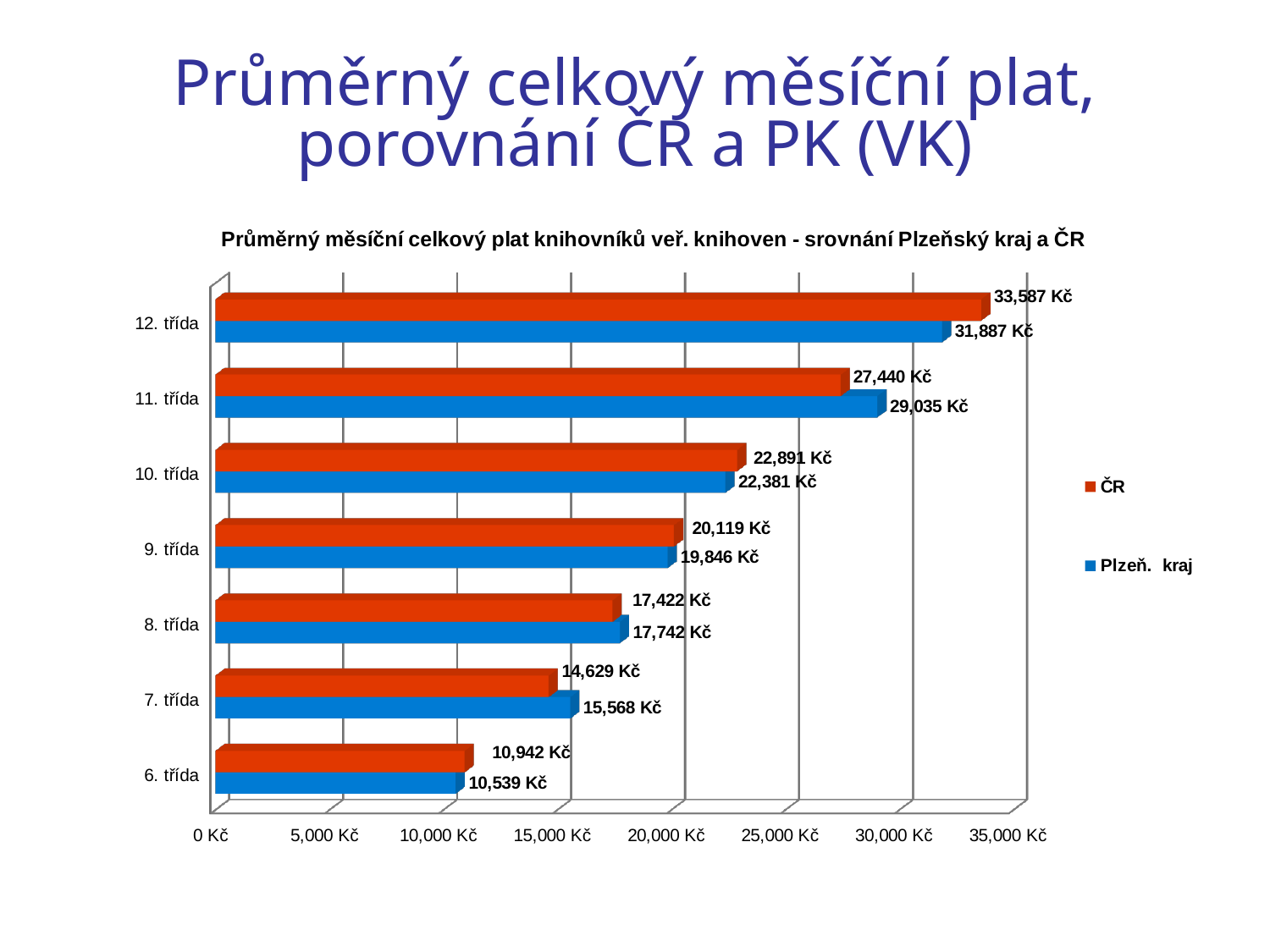
What is the Plzeň. kraj value for 6. třída? 10,539 Kč What is the ČR value for 12. třída? 33,587 Kč What is the difference between the Plzeň. kraj and ČR values for 11. třída? 1,595 Kč What is the ČR value for 7. třída? 14,629 Kč What is the Plzeň. kraj value for 11. třída? 29,035 Kč What is the difference between the ČR and Plzeň. kraj values for 12. třída? 1,700 Kč For 7. třída, which is larger: the ČR value or the Plzeň. kraj value? Plzeň. kraj Which category has the highest ČR value? 12. třída How many series does the legend list? 2 How many categories (třída) are shown on the chart? 7 Which category has the lowest Plzeň. kraj value? 6. třída What kind of chart is shown on the slide? Bar chart